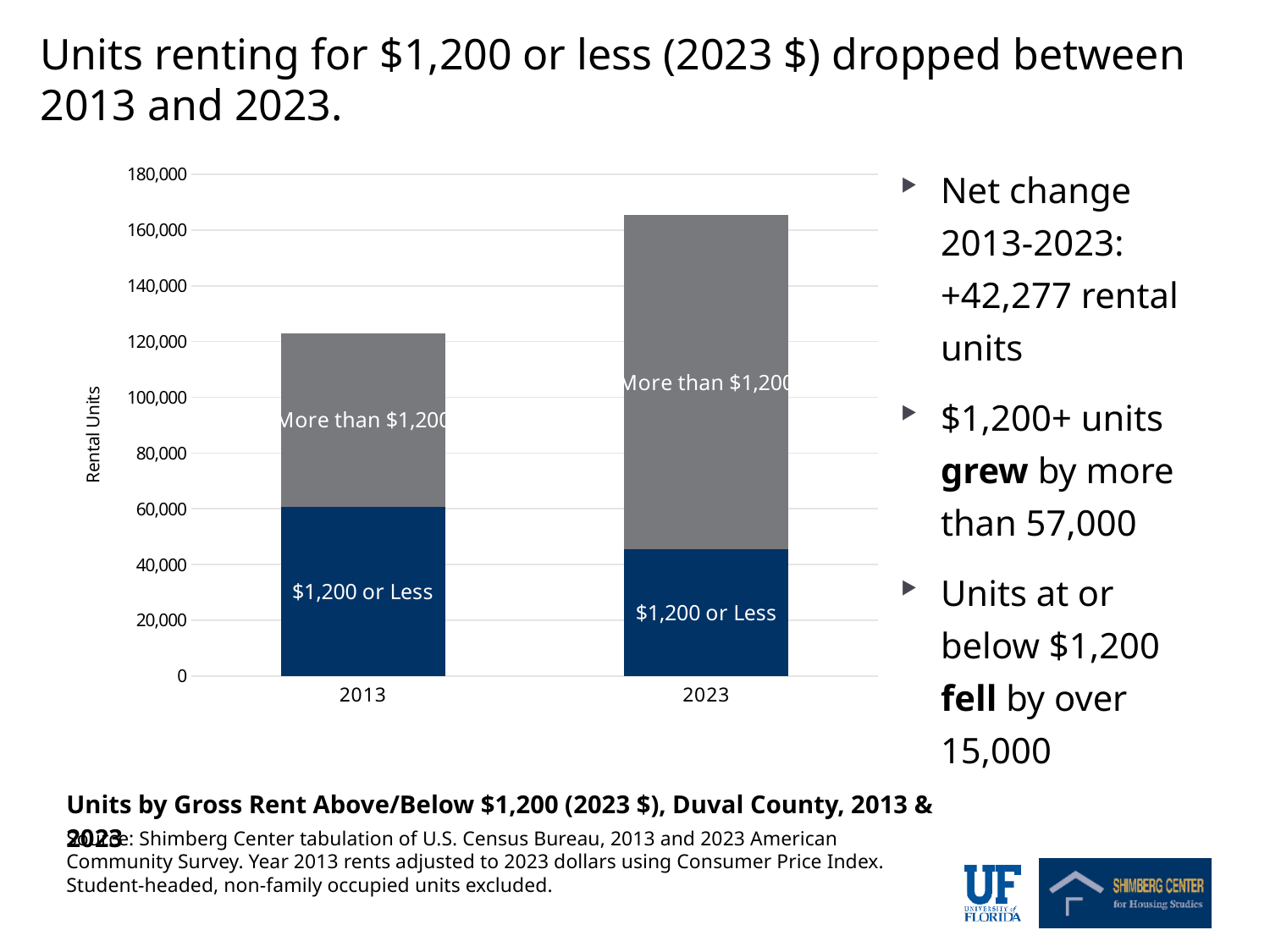
What kind of chart is shown on the slide? Stacked bar chart What is the label on the vertical axis of the chart? Rental Units Is the '$1,200 or Less' segment for 2023 greater or less than 60,000? less How many rent series are stacked in each bar of the chart? 2 Is the total height of the 2013 bar greater or less than 140,000? less Is the total height of the 2023 bar greater or less than 160,000? greater Which year has the taller total bar, 2013 or 2023? 2023 Which rent segment is shown in dark blue at the bottom of each bar? $1,200 or Less Which year has the larger 'More than $1,200' segment, 2013 or 2023? 2023 Which year has the larger '$1,200 or Less' segment, 2013 or 2023? 2013 Does the total number of rental units rise or fall from 2013 to 2023? Rise How many years (categories) are shown on the x axis of the chart? 2